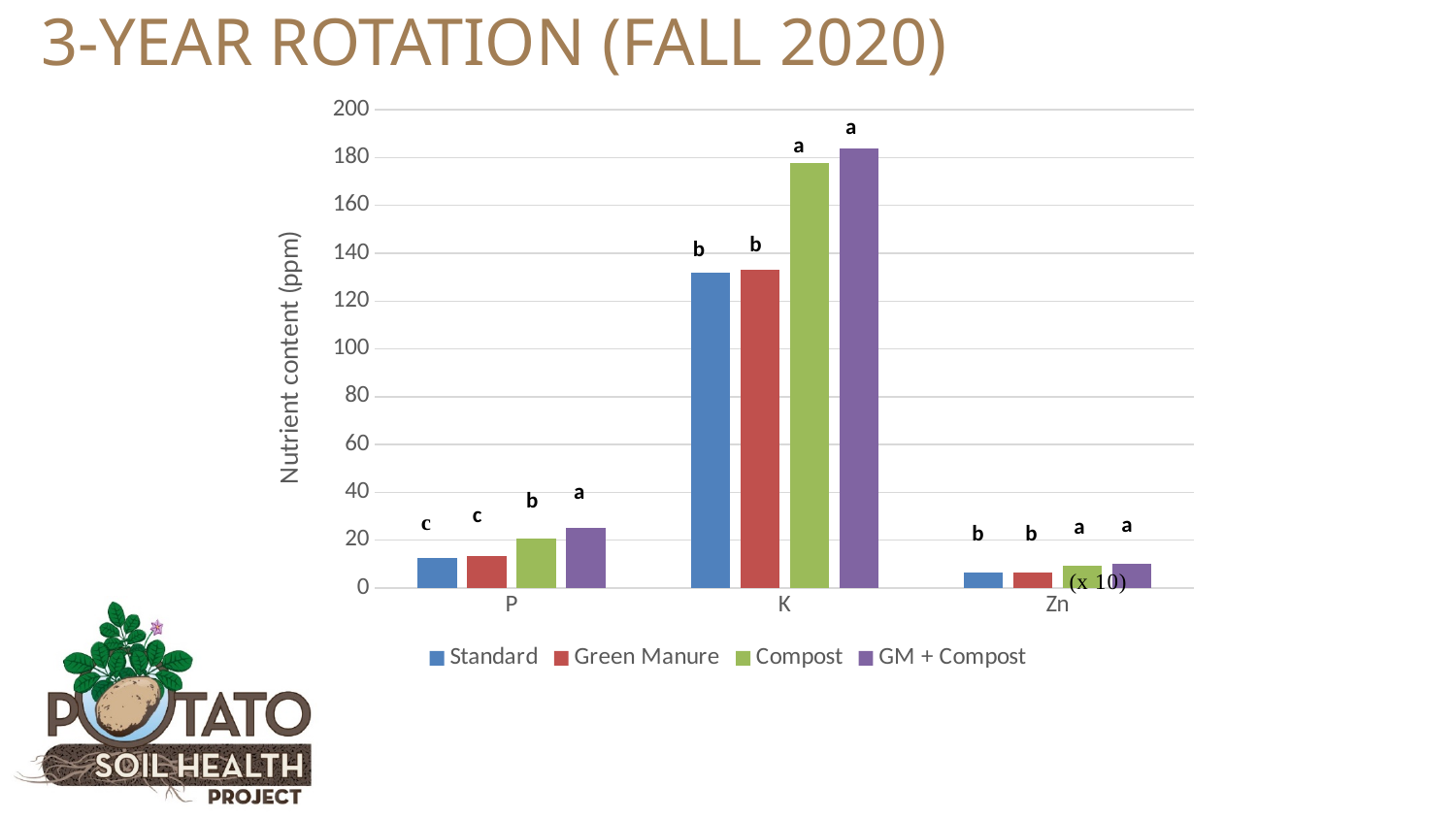
What kind of chart is shown on the slide? bar chart Is the value for Compost in the K category greater or less than 160? greater In the K category, which is larger: Compost or Standard? Compost How many series does the legend list? 4 Which nutrient category has the tallest bars? K What letter is printed above the GM + Compost bar in the P category? a How many nutrient categories are shown on the x axis? 3 Is the value for Standard in the P category greater or less than 20? less Is the value for GM + Compost in the P category greater or less than 20? greater Which nutrient category has the shortest bars? Zn What is the label on the y axis? Nutrient content (ppm)